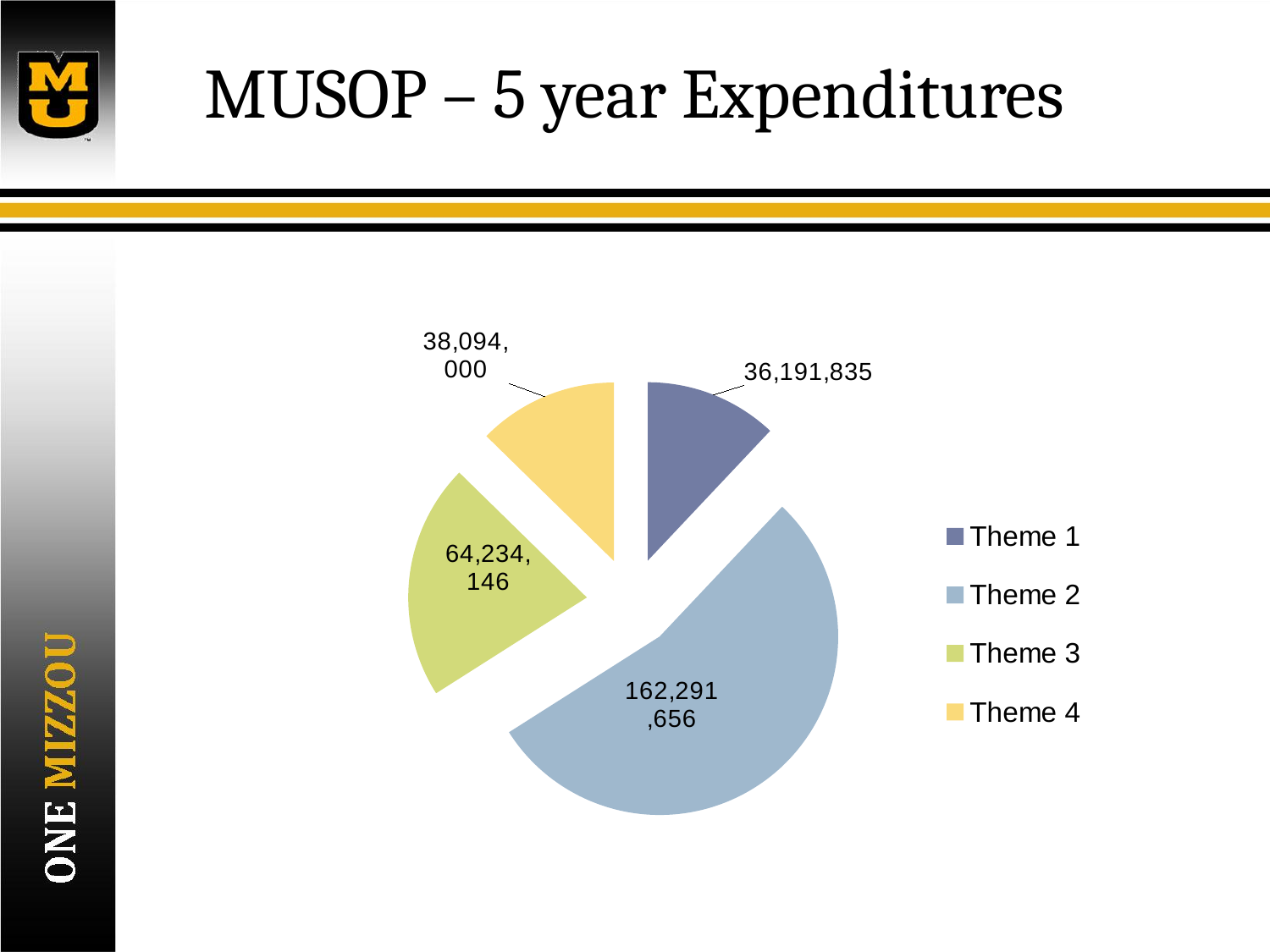
How many slices does the pie chart have? 4 What is the value for Theme 1 in the pie chart? 36,191,835 Which theme has the smallest expenditure in the pie chart? Theme 1 Which is larger, the value for Theme 3 or the value for Theme 4? Theme 3 What is the value for Theme 3 in the pie chart? 64,234,146 What is the title of the slide containing the chart? MUSOP – 5 year Expenditures What is the difference between the values for Theme 2 and Theme 3? 98,057,510 Which theme has the largest expenditure in the pie chart? Theme 2 What is the value for Theme 2 in the pie chart? 162,291,656 What is the difference between the values for Theme 4 and Theme 1? 1,902,165 What is the value for Theme 4 in the pie chart? 38,094,000 What kind of chart is shown on the slide? Pie chart